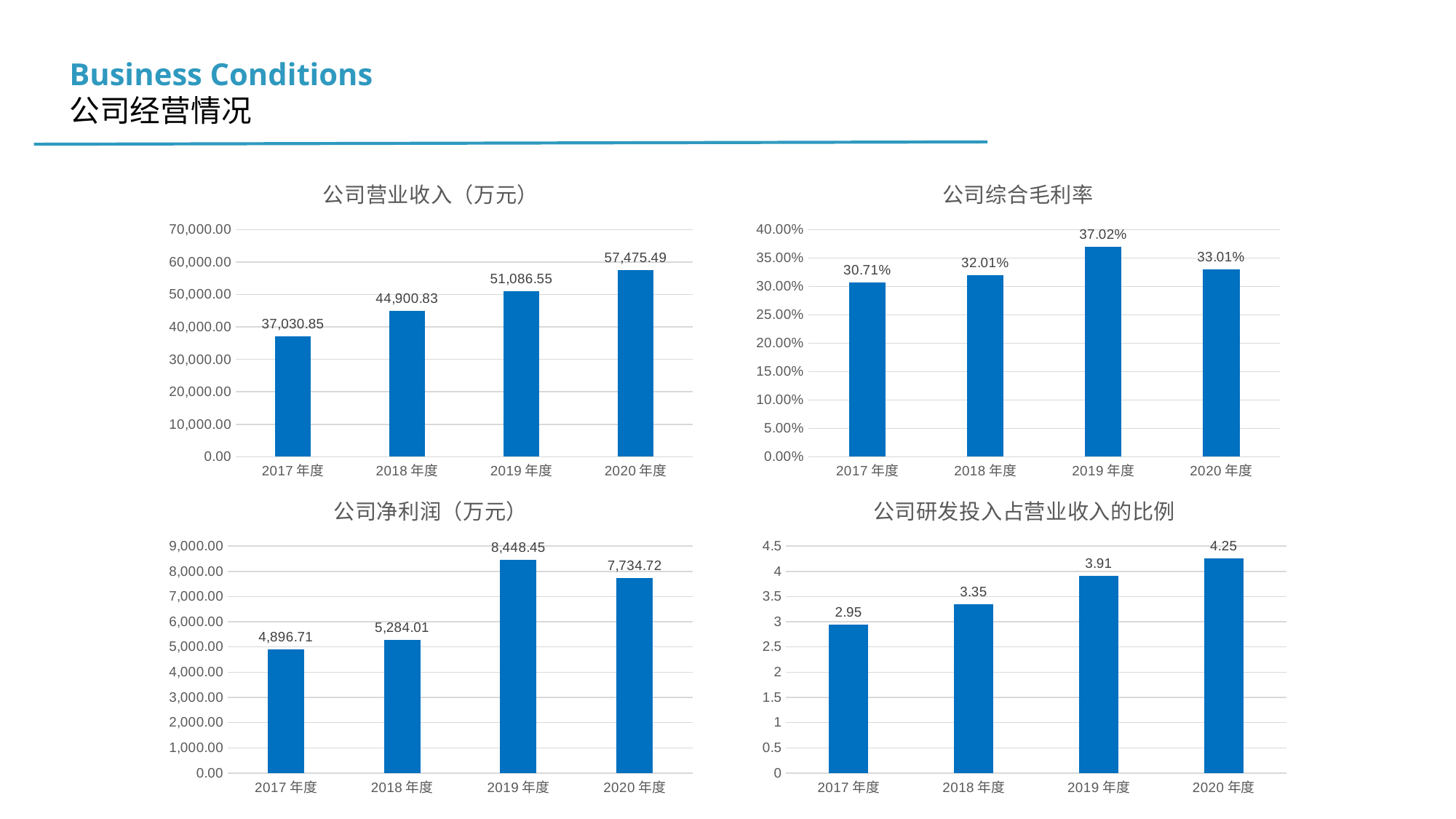
In the 公司营业收入（万元） chart, which year has the lowest value? 2017 年度 In the 公司研发投入占营业收入的比例 chart, do the values rise or fall from 2017 年度 to 2020 年度? rise In the 公司综合毛利率 chart, which is larger, the value for 2018 年度 or 2020 年度? 2020 年度 In the 公司净利润（万元） chart, what is the difference between the 2019 年度 and 2020 年度 values? 713.73 What kind of chart is the 公司综合毛利率 chart? bar chart In the 公司净利润（万元） chart, what is the value for 2018 年度? 5,284.01 In the 公司营业收入（万元） chart, what is the value for 2020 年度? 57,475.49 In the 公司综合毛利率 chart, which year has the highest value? 2019 年度 In the 公司研发投入占营业收入的比例 chart, what is the value for 2017 年度? 2.95 How many years are shown in the 公司净利润（万元） chart? 4 In the 公司营业收入（万元） chart, what is the difference between the 2020 年度 and 2017 年度 values? 20,444.64 In the 公司综合毛利率 chart, what is the value for 2019 年度? 37.02%